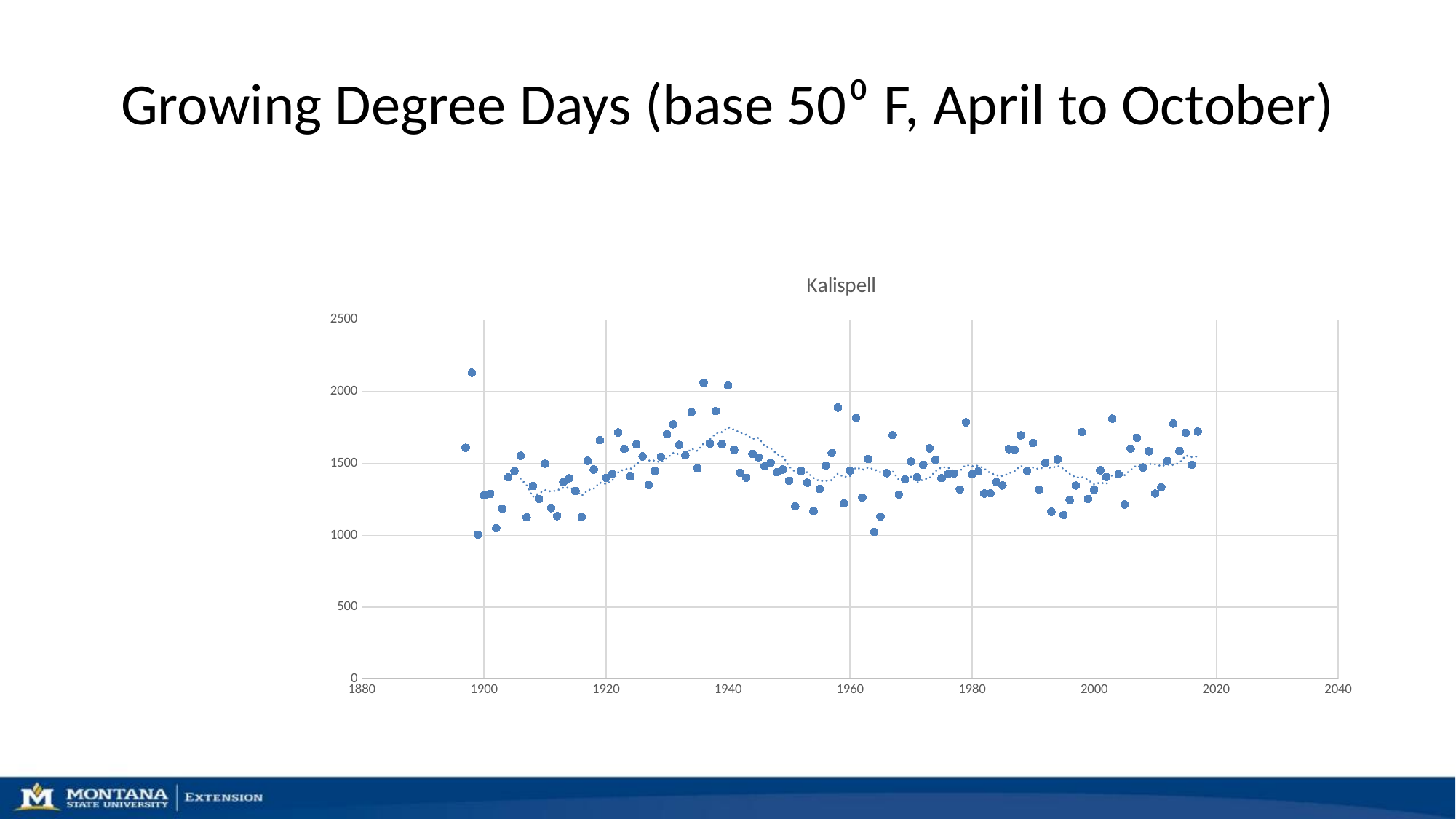
Is the highest plotted value after 1960 greater or less than 2000? less Is the lowest plotted point on the chart greater or less than 500? greater Is the highest plotted value between 1920 and 1940 greater or less than 1500? greater What is the title of the chart? Kalispell What kind of chart is shown on the slide? scatter chart What is the highest value labelled on the chart's vertical axis? 2500